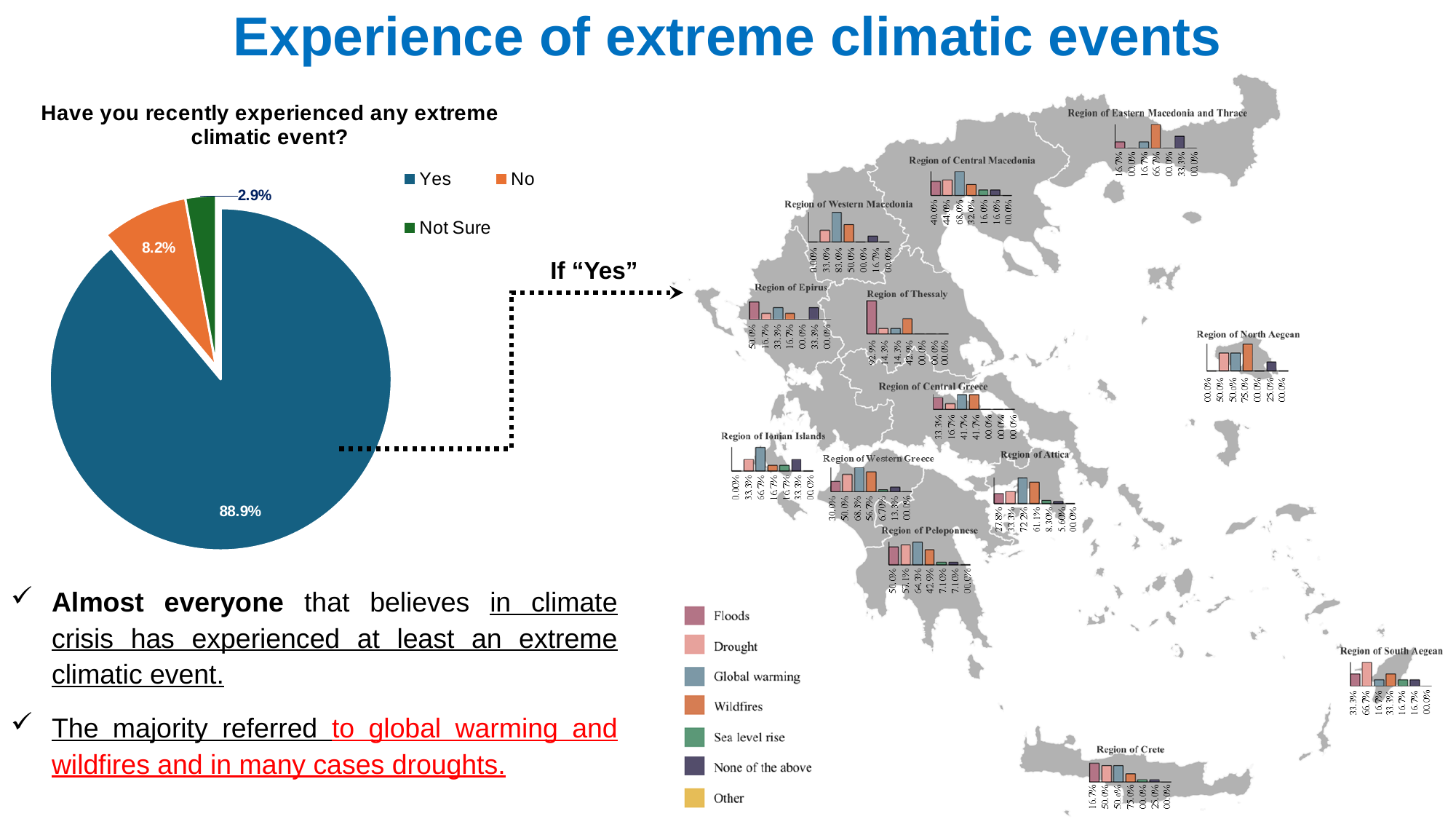
In the pie chart, which response has the largest share? Yes In the pie chart, what percentage of respondents answered "No"? 8.2% In the pie chart, which is larger: the "No" share or the "Not Sure" share? No What is the title of the pie chart on the left of the slide? Have you recently experienced any extreme climatic event? How many slices does the pie chart have? 3 In the Region of Thessaly bar chart on the map, which category has the highest value? Floods What type of chart is used to show the answers to "Have you recently experienced any extreme climatic event?"? Pie chart In the pie chart, which response has the smallest share? Not Sure In the pie chart, what percentage of respondents answered "Not Sure"? 2.9% How many categories does the legend of the map bar charts list? 7 In the pie chart, what is the difference in percentage points between the "Yes" and "No" shares? 80.7 In the pie chart, what percentage of respondents answered "Yes"? 88.9%